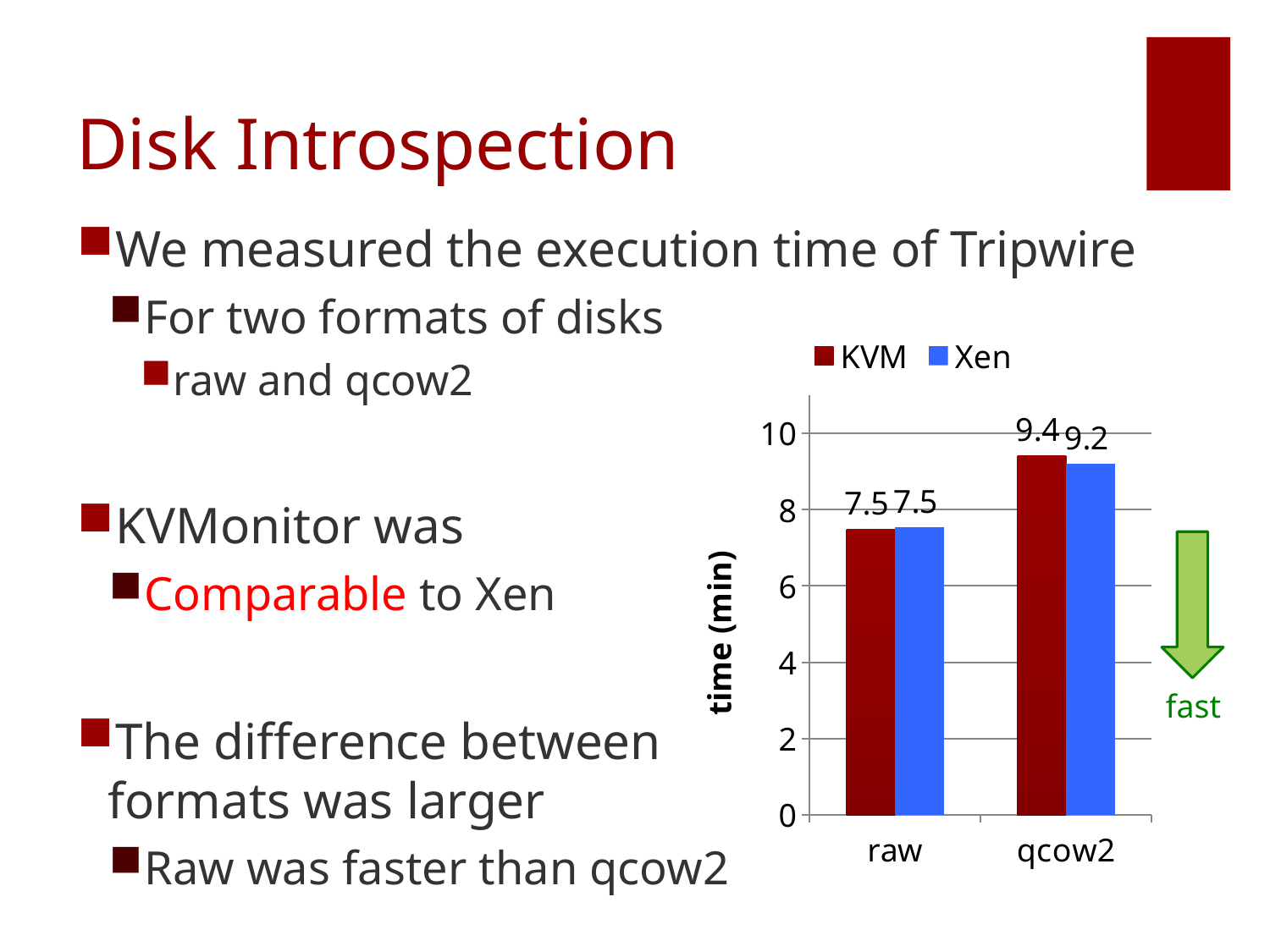
What is the KVM value for raw? 7.5 What is the difference between the KVM values for qcow2 and raw? 1.9 Which disk format has the lower Xen value? raw Is the KVM value for qcow2 greater or less than 8? greater How many disk formats are shown on the x axis? 2 What is the label of the y axis? time (min) What kind of chart is shown? bar chart What is the difference between the Xen values for qcow2 and raw? 1.7 How many series does the legend list? 2 What is the Xen value for qcow2? 9.2 What is the KVM value for qcow2? 9.4 Which disk format has the higher KVM value? qcow2